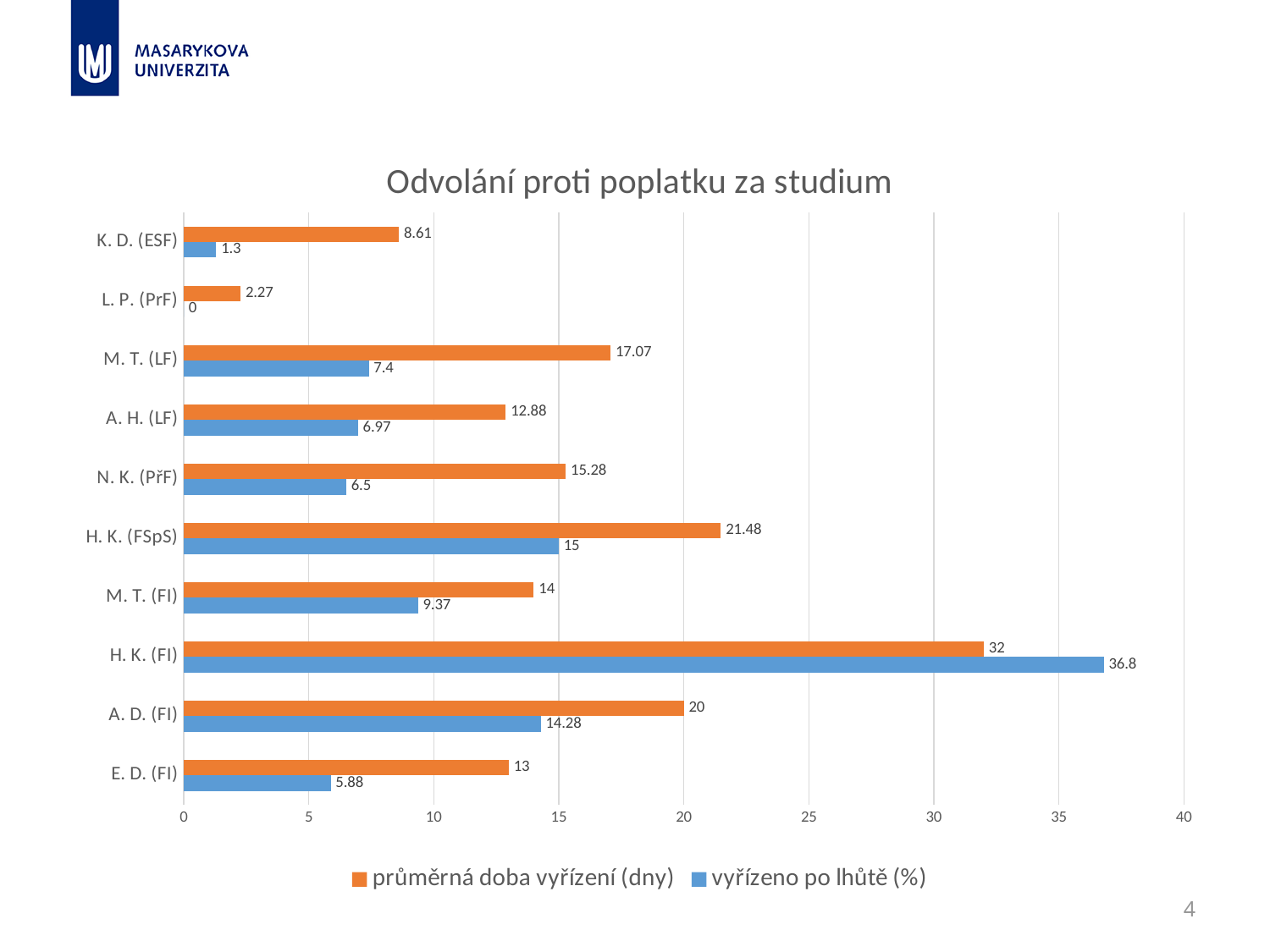
Which category has the lowest value of vyřízeno po lhůtě (%)? L. P. (PrF) What is the title of the chart? Odvolání proti poplatku za studium How many categories are shown on the chart? 10 Which is larger for M. T. (LF): průměrná doba vyřízení (dny) or vyřízeno po lhůtě (%)? průměrná doba vyřízení (dny) What is the difference between the průměrná doba vyřízení (dny) values for H. K. (FI) and A. D. (FI)? 12 Is the vyřízeno po lhůtě (%) value for H. K. (FI) greater or less than 35? greater Which category has the highest value of průměrná doba vyřízení (dny)? H. K. (FI) What kind of chart is shown on the slide? bar chart What is the value of vyřízeno po lhůtě (%) for A. D. (FI)? 14.28 How many series does the legend list? 2 What is the value of vyřízeno po lhůtě (%) for L. P. (PrF)? 0 What is the value of průměrná doba vyřízení (dny) for H. K. (FSpS)? 21.48